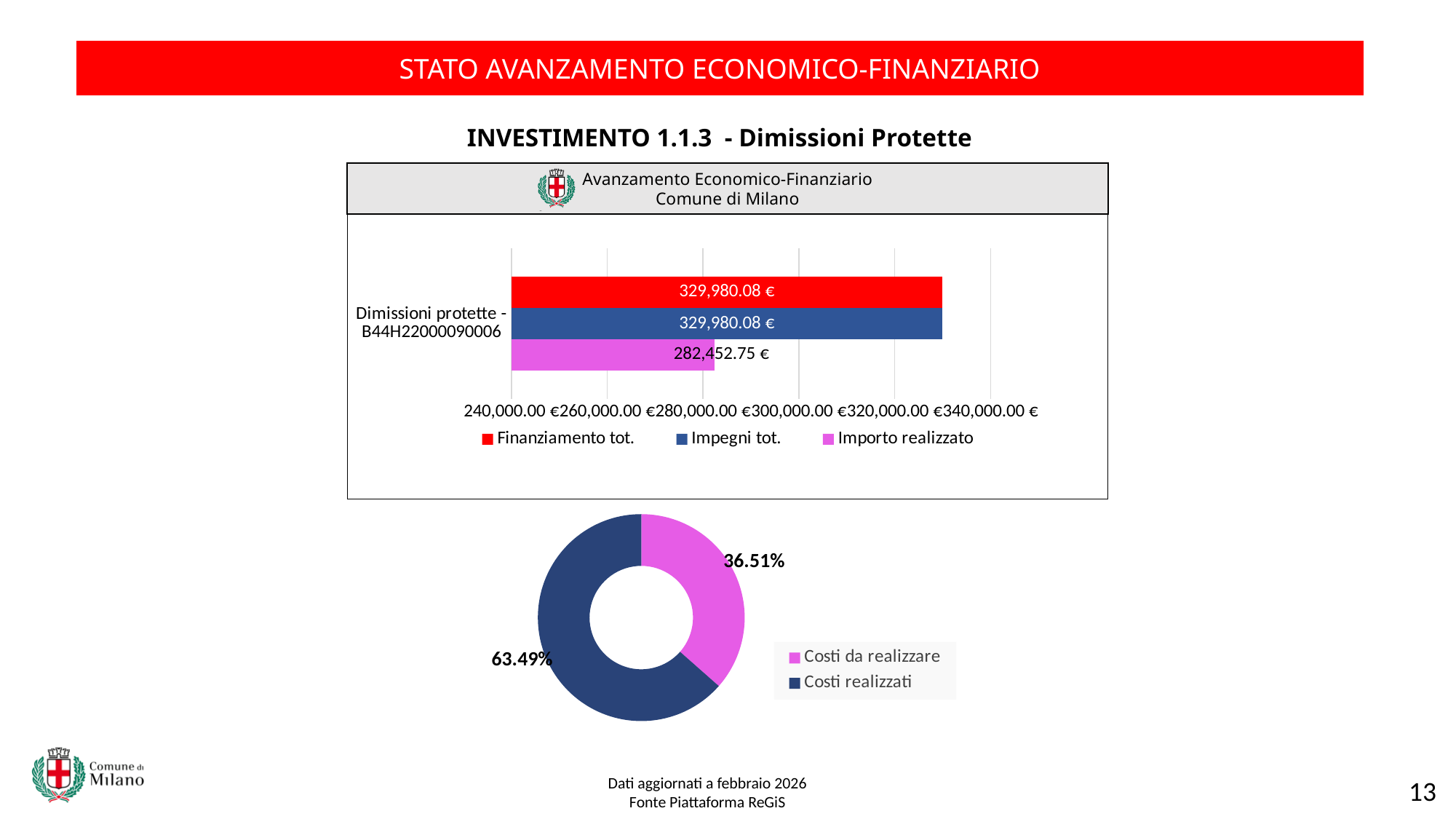
What kind of chart is the upper chart titled 'Avanzamento Economico-Finanziario Comune di Milano'? Bar chart In the donut chart at the bottom of the slide, what share is Costi realizzati? 63.49% In the bar chart titled 'Avanzamento Economico-Finanziario Comune di Milano', is the value for Importo realizzato greater or less than 300,000.00 €? less In the bar chart titled 'Avanzamento Economico-Finanziario Comune di Milano', what is the value of Importo realizzato? 282,452.75 € In the bar chart titled 'Avanzamento Economico-Finanziario Comune di Milano', what is the value of Impegni tot.? 329,980.08 € In the bar chart titled 'Avanzamento Economico-Finanziario Comune di Milano', which is larger: Impegni tot. or Importo realizzato? Impegni tot. In the donut chart at the bottom of the slide, what share is Costi da realizzare? 36.51% In the bar chart titled 'Avanzamento Economico-Finanziario Comune di Milano', what is the value of Finanziamento tot.? 329,980.08 € How many series does the legend of the bar chart titled 'Avanzamento Economico-Finanziario Comune di Milano' list? 3 In the donut chart at the bottom of the slide, which slice is the largest? Costi realizzati In the bar chart titled 'Avanzamento Economico-Finanziario Comune di Milano', what is the difference between Finanziamento tot. and Importo realizzato? 47,527.33 € In the bar chart titled 'Avanzamento Economico-Finanziario Comune di Milano', which series has the lowest value? Importo realizzato